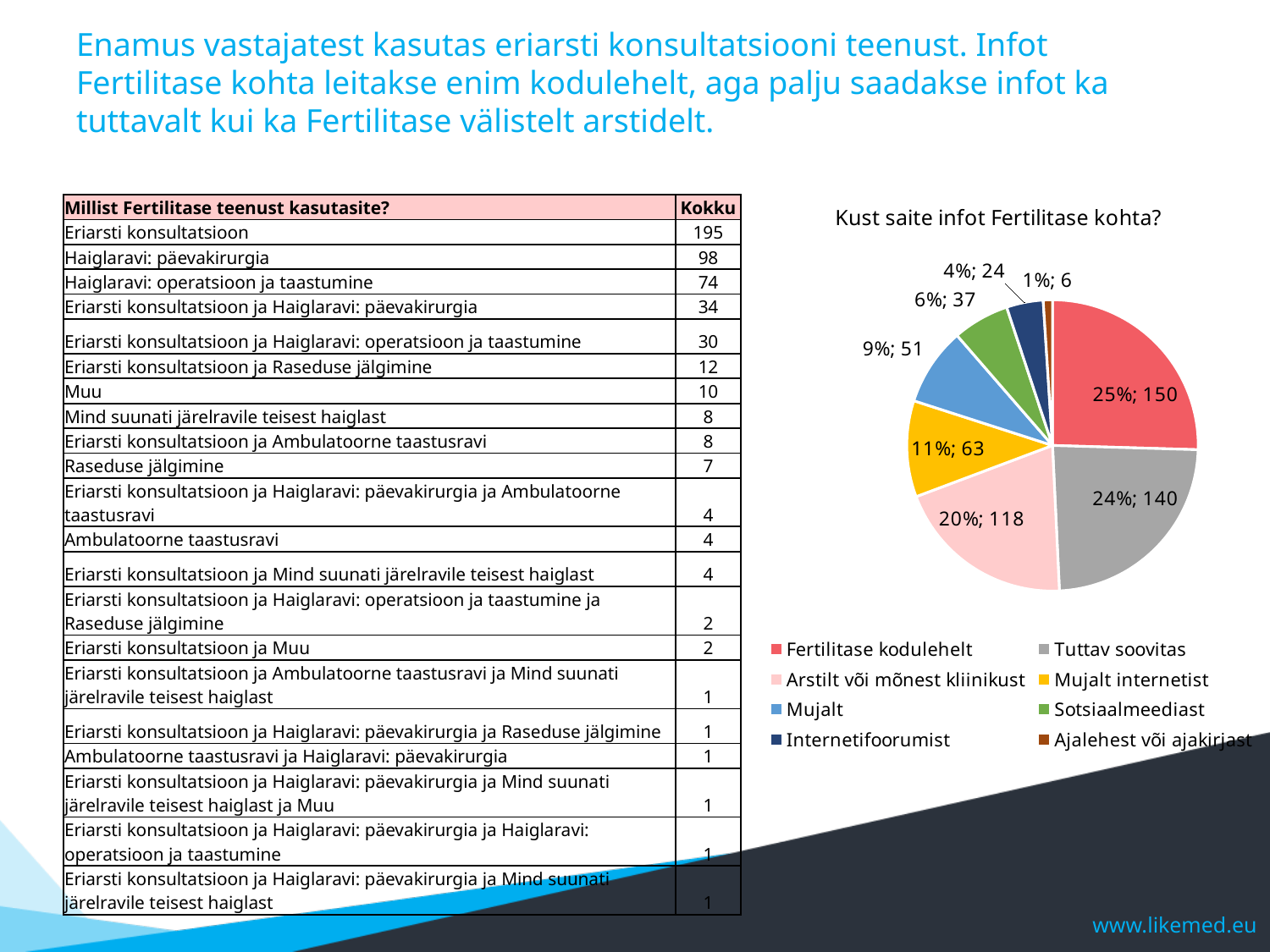
What value is shown for the Fertilitase kodulehelt slice of the pie chart? 25%; 150 What value is shown for the Tuttav soovitas slice of the pie chart? 24%; 140 What value is shown for the Arstilt või mõnest kliinikust slice of the pie chart? 20%; 118 What colour is the Mujalt slice in the pie chart? blue What is the difference in count between the Fertilitase kodulehelt slice and the Tuttav soovitas slice? 10 What is the title of the pie chart? Kust saite infot Fertilitase kohta? What share of the pie does Mujalt internetist represent? 11% What kind of chart is shown on the slide? pie chart How many slices does the pie chart have? 8 Which slice of the pie chart is the largest? Fertilitase kodulehelt Which slice of the pie chart is the smallest? Ajalehest või ajakirjast Which is larger in the pie chart: Sotsiaalmeediast or Internetifoorumist? Sotsiaalmeediast